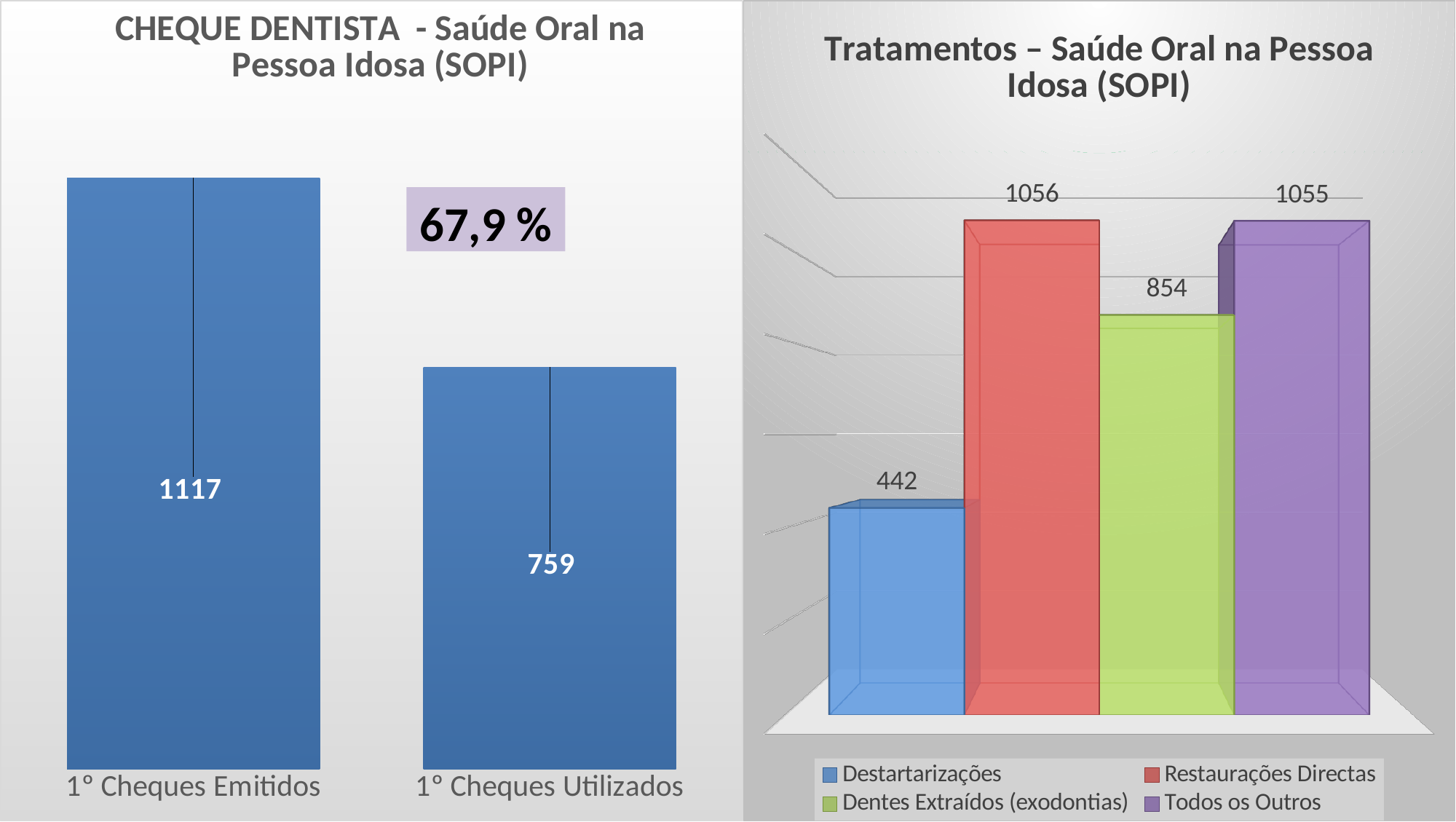
In the CHEQUE DENTISTA chart, what is the difference between 1º Cheques Emitidos and 1º Cheques Utilizados? 358 In the Tratamentos chart, what is the value for Restaurações Directas? 1056 In the Tratamentos chart, which is larger: Restaurações Directas or Dentes Extraídos (exodontias)? Restaurações Directas In the Tratamentos chart, which category has the lowest value? Destartarizações How many entries does the legend of the Tratamentos chart list? 4 In the Tratamentos chart, what is the value for Destartarizações? 442 In the CHEQUE DENTISTA chart, which category has the higher value? 1º Cheques Emitidos In the CHEQUE DENTISTA chart, what is the value for 1º Cheques Utilizados? 759 In the Tratamentos chart, what is the value for Dentes Extraídos (exodontias)? 854 In the CHEQUE DENTISTA chart, what is the value for 1º Cheques Emitidos? 1117 What kind of chart is the CHEQUE DENTISTA chart? Bar chart In the CHEQUE DENTISTA chart, what percentage is shown in the highlighted box? 67,9 %